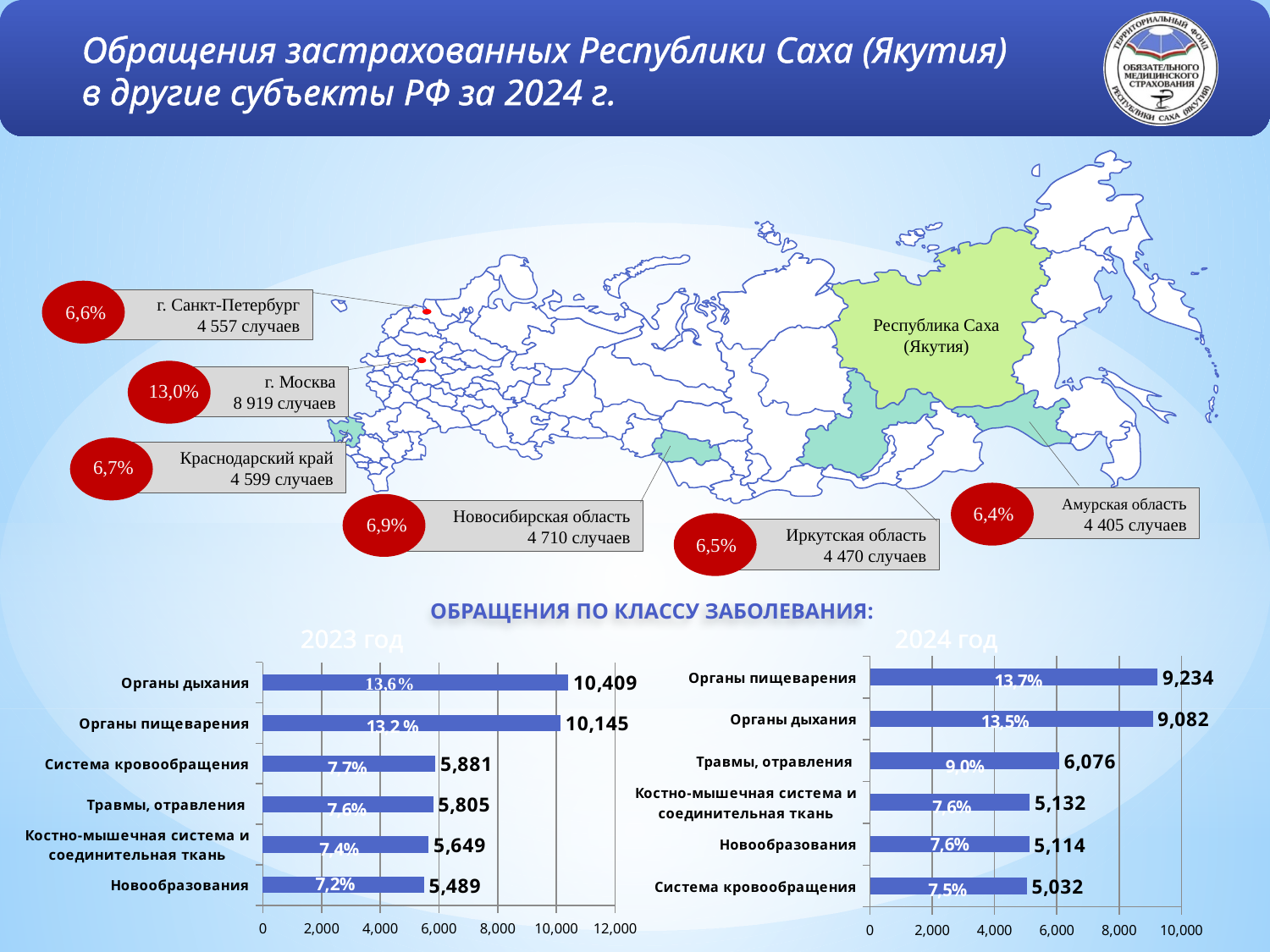
How many categories are shown in the 2023 год chart? 6 In the 2023 год chart, which category has the highest value? Органы дыхания In the 2024 год chart, what percentage is shown on the bar for Органы пищеварения? 13,7% In the 2024 год chart, which category has the lowest value? Система кровообращения What type of chart is the 2024 год chart? bar chart In the 2024 год chart, what is the value for Травмы, отравления? 6,076 In the 2023 год chart, what is the difference between Органы дыхания and Органы пищеварения? 264 In the 2023 год chart, which is larger: Система кровообращения or Новообразования? Система кровообращения In the 2024 год chart, what is the difference between Органы пищеварения and Органы дыхания? 152 In the 2024 год chart, is the value for Травмы, отравления greater or less than 6,000? greater In the 2023 год chart, what is the value for Костно-мышечная система и соединительная ткань? 5,649 In the 2023 год chart, what is the value for Органы дыхания? 10,409